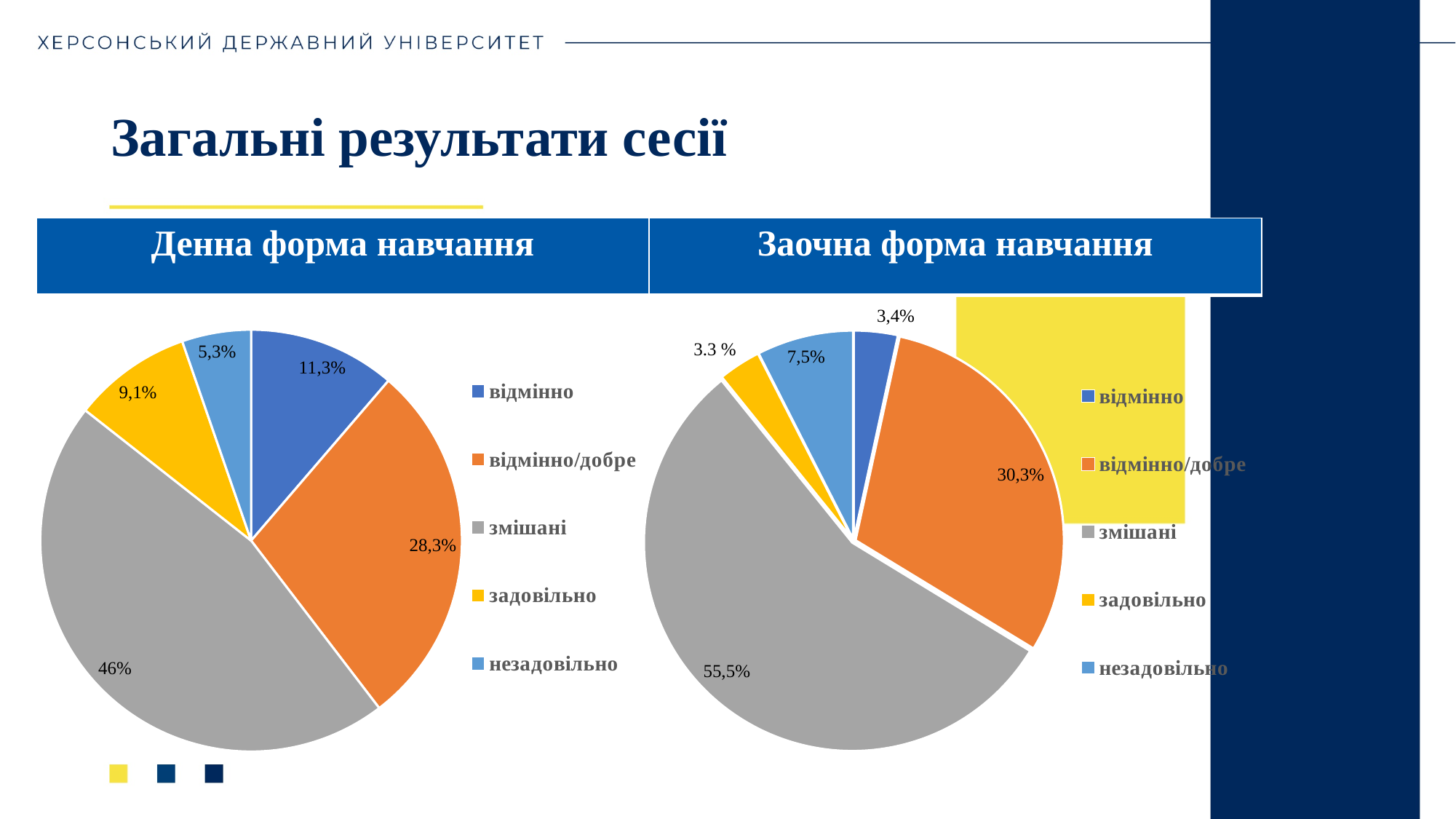
In the "Денна форма навчання" chart, which category has the smallest slice? незадовільно In the "Денна форма навчання" chart, which category has the largest slice? змішані What type of chart is used for "Заочна форма навчання"? Pie chart In the "Заочна форма навчання" chart, what is the value for "відмінно/добре"? 30,3% In the "Заочна форма навчання" chart, which category has the largest slice? змішані In the "Денна форма навчання" chart, what is the difference between the "відмінно/добре" and "відмінно" values? 17% In the "Денна форма навчання" chart, what share is labelled for the "змішані" slice? 46% How many slices does the "Денна форма навчання" pie chart have? 5 In the "Заочна форма навчання" chart, what colour is the "змішані" slice? Grey In the "Денна форма навчання" chart, what is the value for "відмінно"? 11,3% In the "Заочна форма навчання" chart, which is larger: "незадовільно" or "відмінно"? незадовільно In the "Заочна форма навчання" chart, what is the value for "незадовільно"? 7,5%